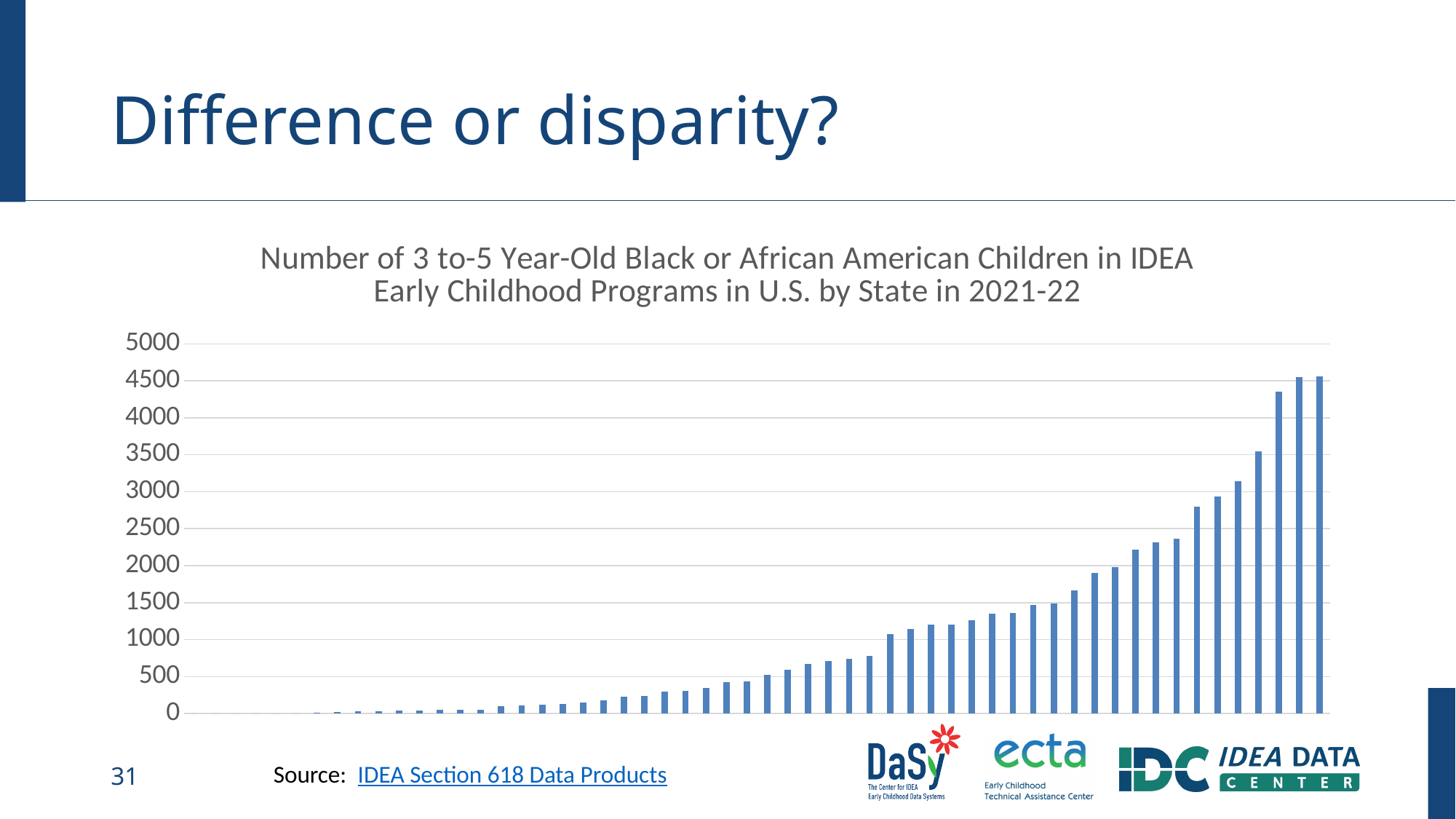
Is the value of the third bar from the right greater or less than 4000? greater What is the title of the chart? Number of 3 to-5 Year-Old Black or African American Children in IDEA Early Childhood Programs in U.S. by State in 2021-22 Is the value of the leftmost bar greater or less than 500? less Is the value of the bar in the middle of the chart greater or less than 1000? less What kind of chart is shown on the slide? bar chart Do the bar values rise or fall from left to right along the x axis? rise What is the highest value shown on the y axis? 5000 Which bar is taller, the leftmost bar or the rightmost bar? the rightmost bar